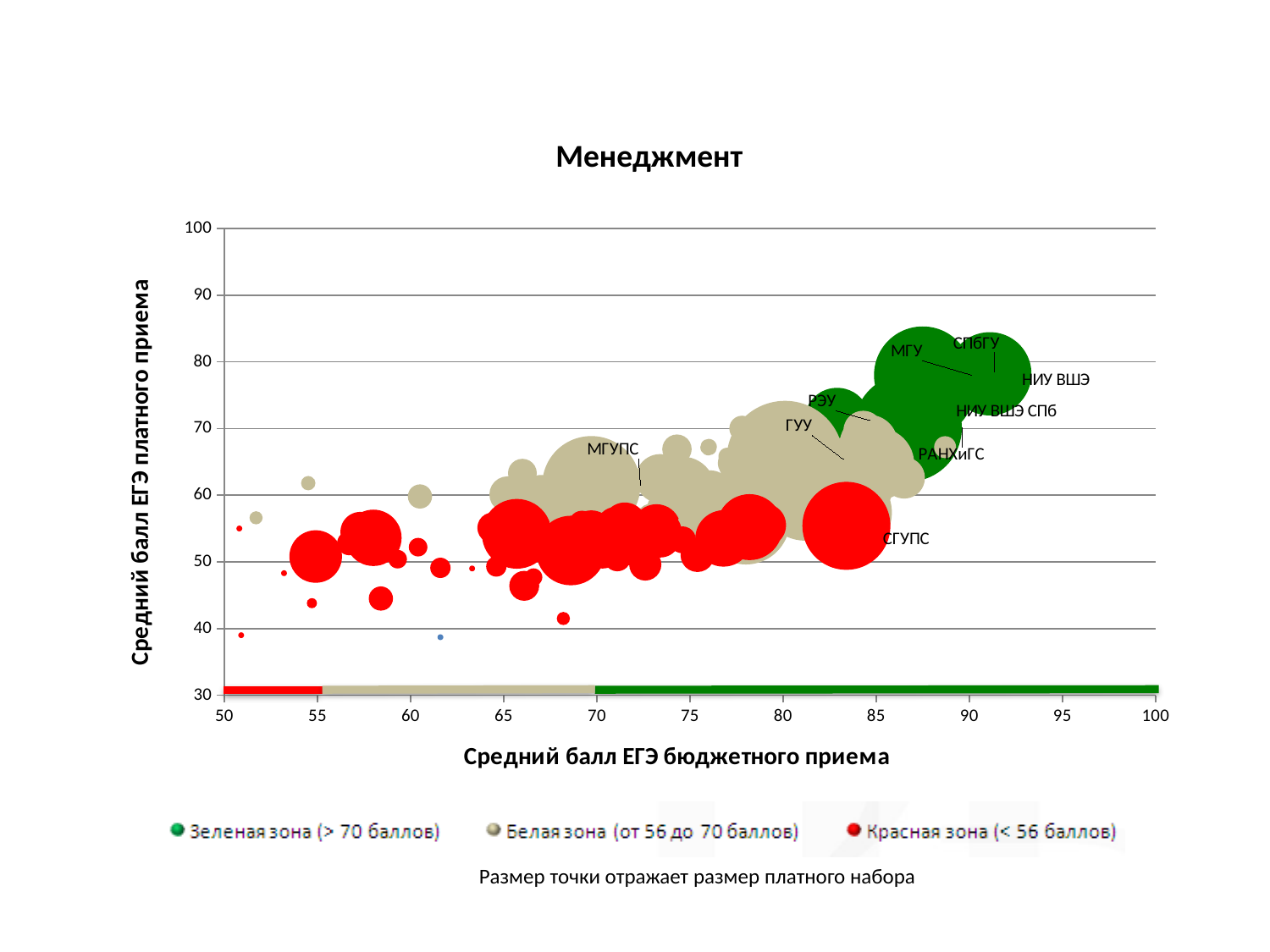
What does the size of a point reflect, according to the note under the chart? размер платного набора Is the value on the vertical axis for НИУ ВШЭ greater or less than 70? greater How many series does the legend list? 3 What is the title of the chart? Менеджмент Is the value on the vertical axis for СПбГУ greater or less than 70? greater Which has the higher value on the vertical axis, НИУ ВШЭ or СГУПС? НИУ ВШЭ Is the value on the horizontal axis (Средний балл ЕГЭ бюджетного приема) for СГУПС greater or less than 80? greater Among the labeled universities, which has the lowest value on the vertical axis? СГУПС What kind of chart is shown on the slide? bubble chart Do the values on the vertical axis generally rise or fall as the horizontal axis value increases? rise